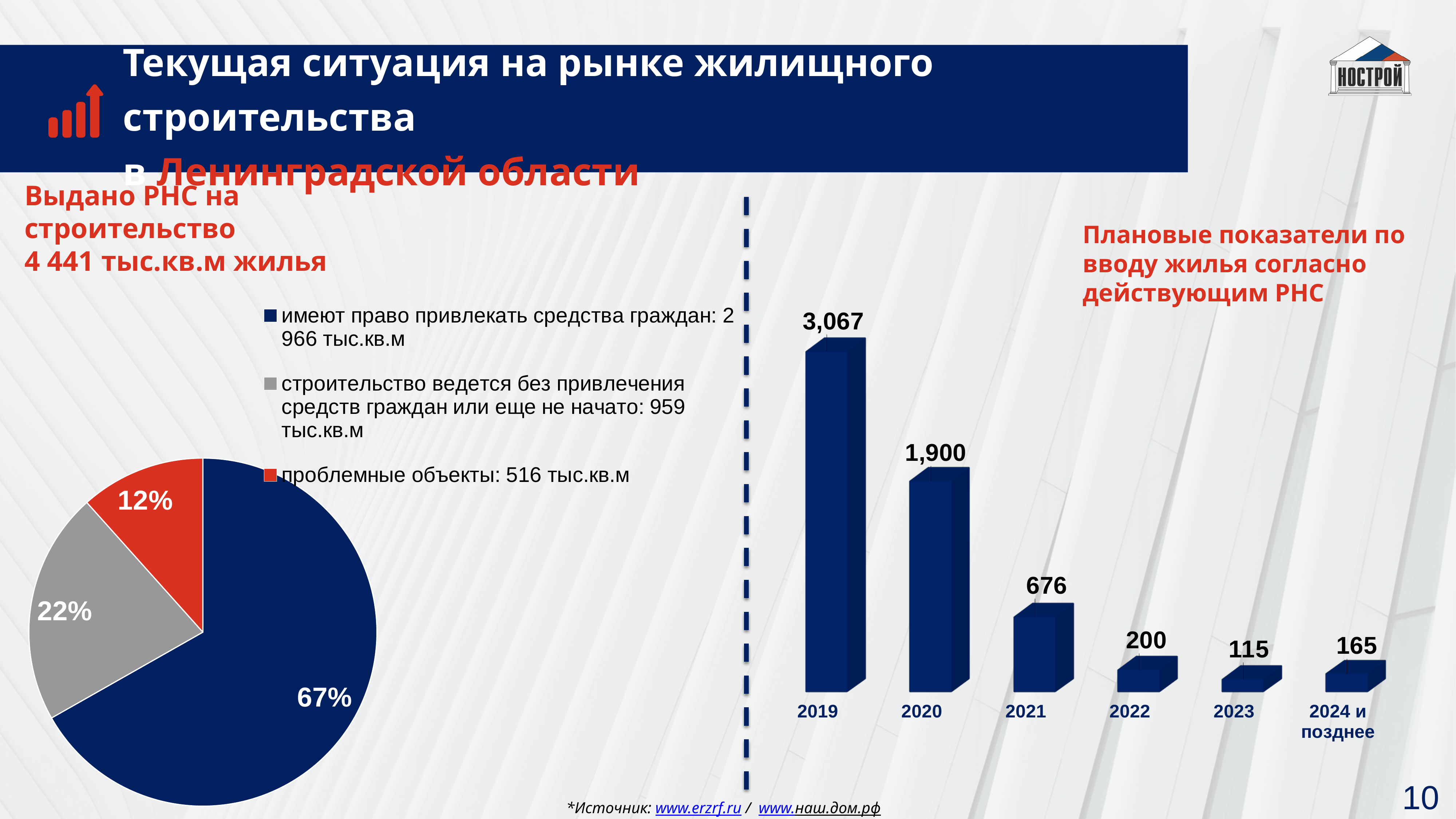
In the bar chart on the right, which is larger: the value for 2022 or the value for 2024 и позднее? 2022 In the pie chart on the left, what share is shown for the slice 'строительство ведется без привлечения средств граждан или еще не начато: 959 тыс.кв.м'? 22% In the bar chart on the right, which category has the lowest value? 2023 In the bar chart on the right, do the values generally rise or fall from 2019 to 2023? fall In the bar chart on the right, what is the value for 2023? 115 In the bar chart on the right, what is the difference between the values for 2019 and 2020? 1,167 How many entries does the legend of the pie chart on the left list? 3 How many bars are in the bar chart on the right? 6 In the pie chart on the left, what share is shown for the slice 'проблемные объекты: 516 тыс.кв.м'? 12% In the bar chart on the right, what is the value for 2021? 676 In the bar chart on the right, what is the value for 2019? 3,067 In the bar chart on the right, which year has the highest value? 2019